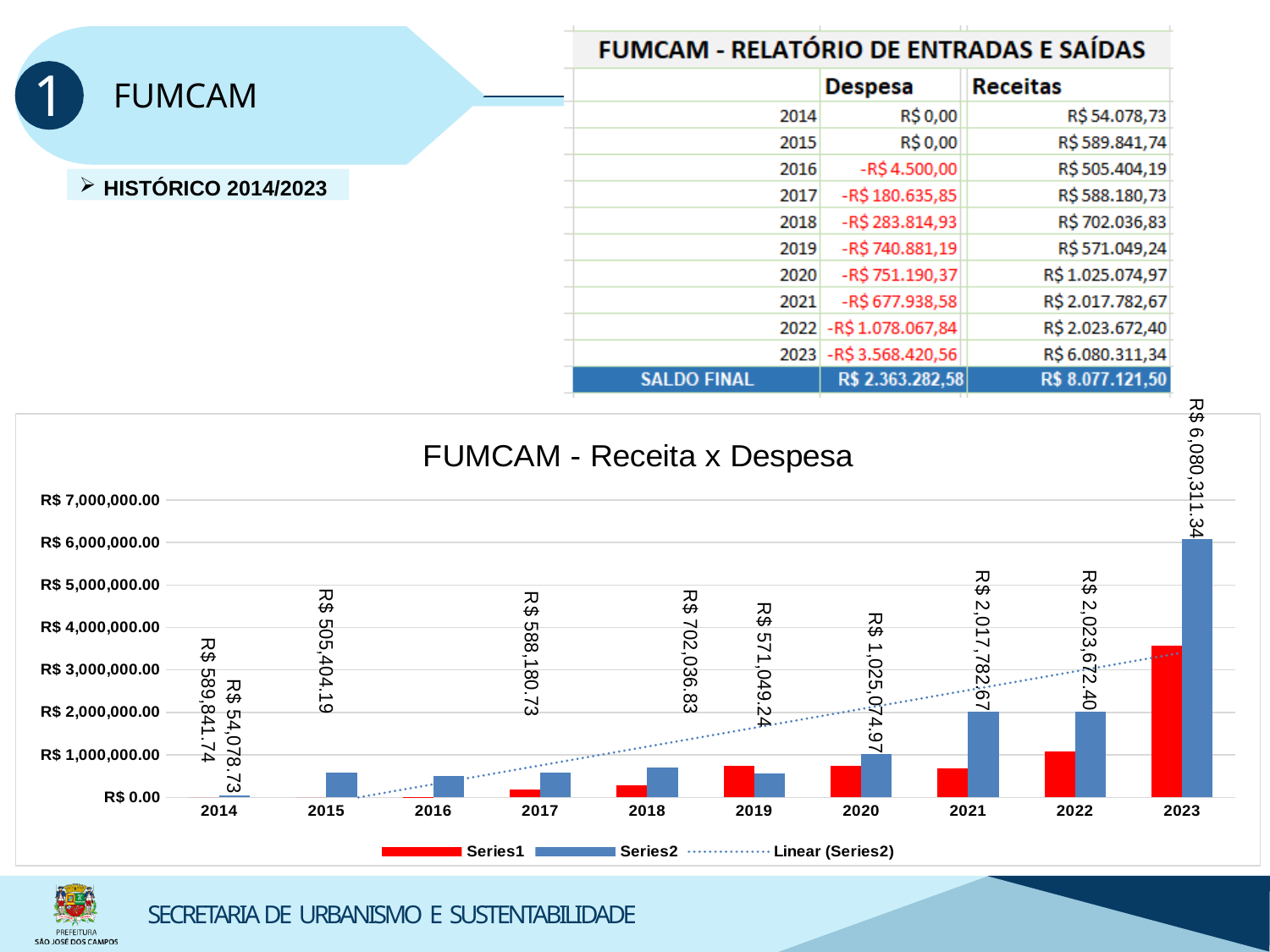
In the "FUMCAM - Receita x Despesa" chart, which year has the larger Series2 value, 2018 or 2019? 2018 How many years are shown on the x axis of the "FUMCAM - Receita x Despesa" chart? 10 In the "FUMCAM - Receita x Despesa" chart, do the Series2 values generally rise or fall from 2014 to 2023? rise In the "FUMCAM - Receita x Despesa" chart, what is the difference between the Series2 values for 2022 and 2021? R$ 5,889.73 What is the Series2 value for 2020 in the "FUMCAM - Receita x Despesa" chart? R$ 1,025,074.97 In the "FUMCAM - Receita x Despesa" chart, is the Series1 value for 2023 greater or less than R$ 3,000,000.00? greater Which year has the highest Series2 value in the "FUMCAM - Receita x Despesa" chart? 2023 What is the Series2 value for 2023 in the "FUMCAM - Receita x Despesa" chart? R$ 6,080,311.34 How many entries does the legend of the "FUMCAM - Receita x Despesa" chart list? 3 What kind of chart is "FUMCAM - Receita x Despesa"? bar chart What is the Series2 value for 2021 in the "FUMCAM - Receita x Despesa" chart? R$ 2,017,782.67 In the "FUMCAM - Receita x Despesa" chart, what is the difference between the Series2 values for 2023 and 2022? R$ 4,056,638.94